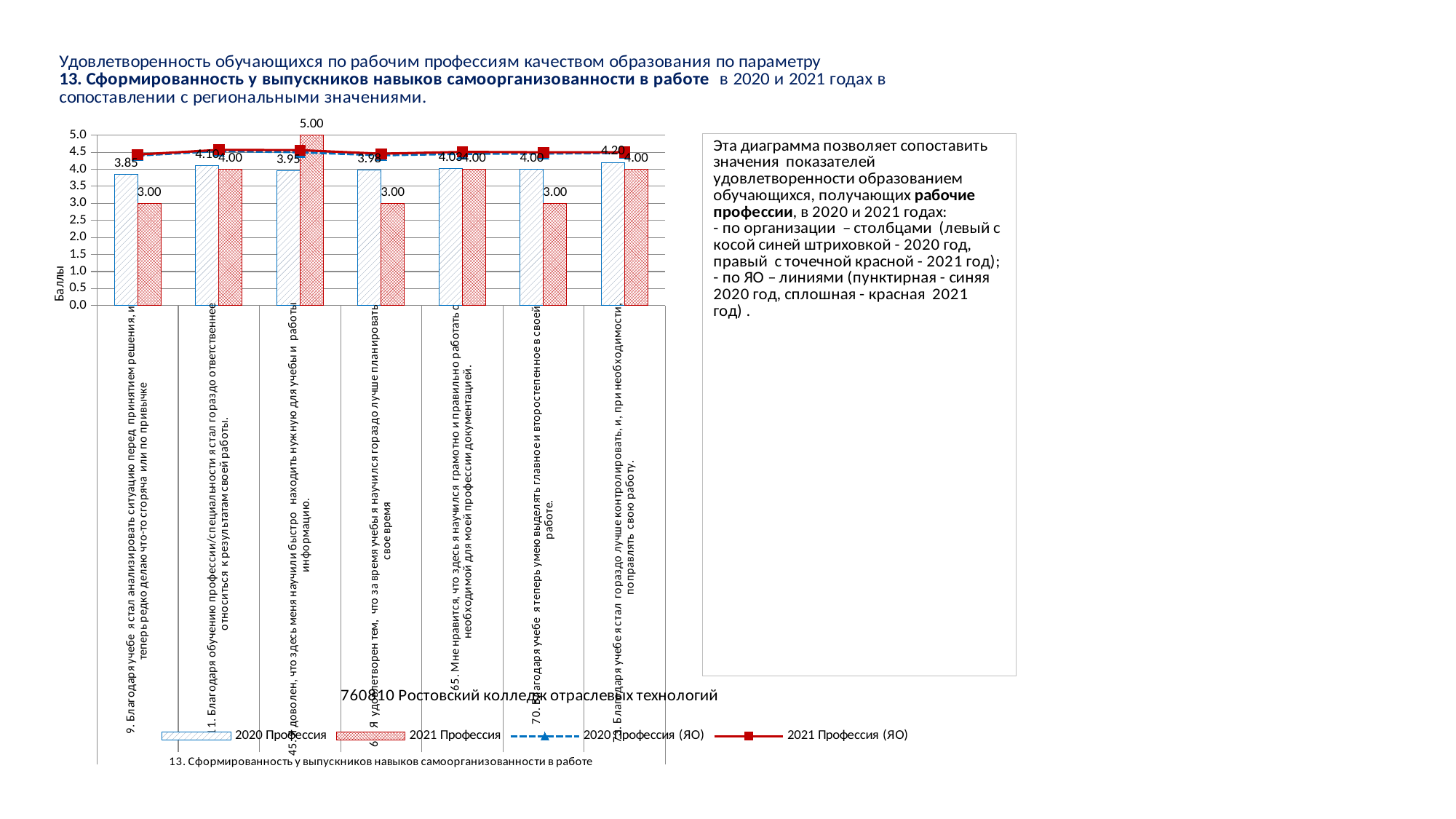
Which statement has the highest 2021 Профессия bar? 45. Я доволен, что здесь меня научили быстро находить нужную для учебы и работы информацию What is the 2020 Профессия value for the last category on the x axis ("Благодаря учебе я стал гораздо лучше контролировать... свою работу")? 4.20 What is the 2021 Профессия value for statement 45 ("Я доволен, что здесь меня научили быстро находить нужную для учебы и работы информацию")? 5.00 What kind of chart is shown on the slide? bar chart (with line series) Is the 2021 Профессия (ЯО) line value for statement 9 greater or less than 4.0? greater What is the 2020 Профессия value for statement 9 ("Благодаря учебе я стал анализировать ситуацию перед принятием решения")? 3.85 How many categories (statements) are plotted along the x axis? 7 For statement 70 ("Благодаря учебе я теперь умею выделять главное и второстепенное в своей работе"), which is larger: the 2020 Профессия value or the 2021 Профессия value? 2020 Профессия What is the title of the vertical axis? Баллы For statement 45, what is the difference between the 2021 Профессия value and the 2020 Профессия value? 1.05 How many series does the chart legend list? 4 Which statement has the lowest 2020 Профессия bar? 9. Благодаря учебе я стал анализировать ситуацию перед принятием решения